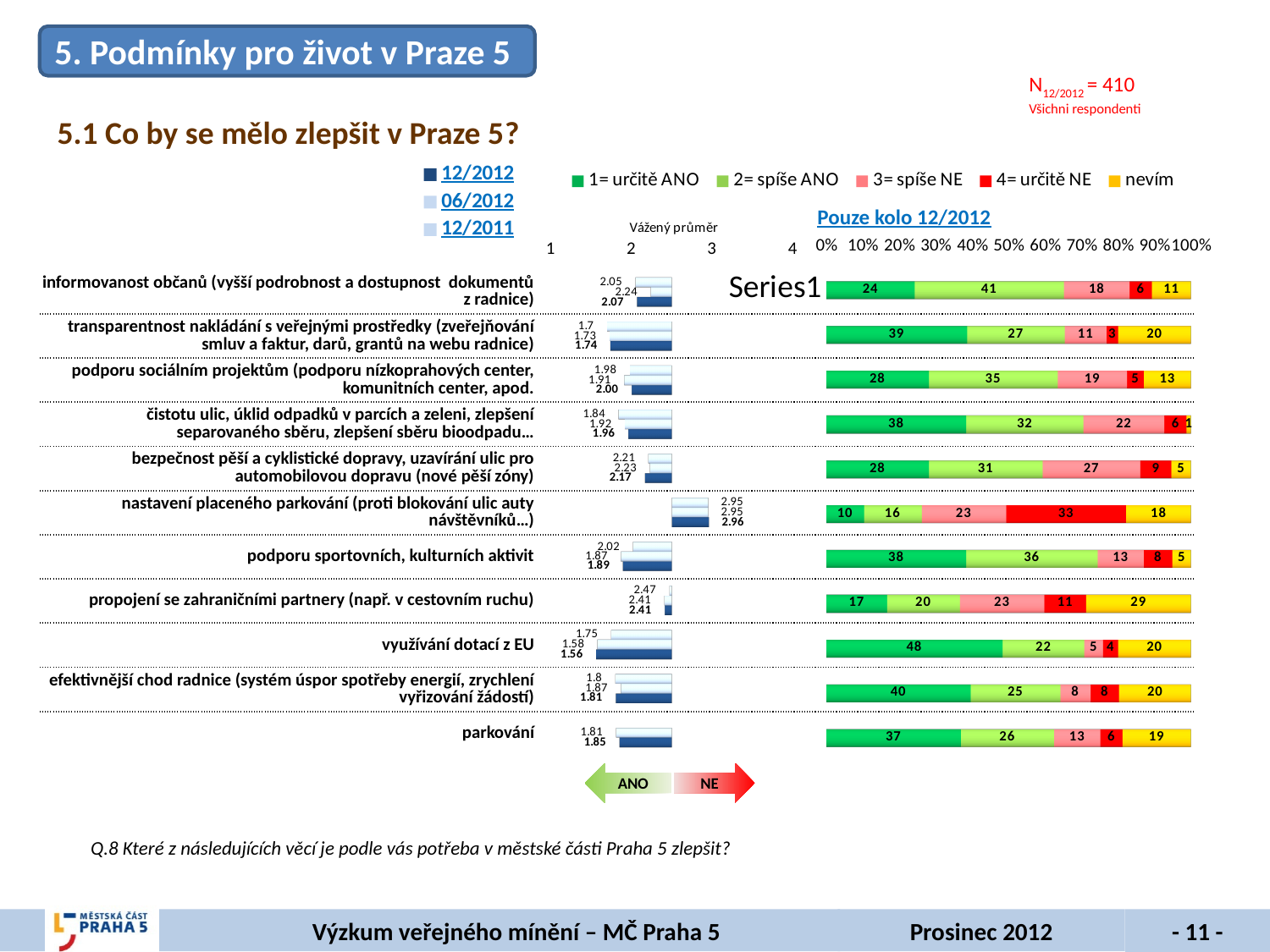
In the stacked bar chart (Pouze kolo 12/2012), which category has the highest value for '1= určitě ANO'? využívání dotací z EU In the stacked bar chart (Pouze kolo 12/2012), which has the larger 'nevím' value: 'transparentnost nakládání s veřejnými prostředky' or 'bezpečnost pěší a cyklistické dopravy'? transparentnost nakládání s veřejnými prostředky In the stacked bar chart (Pouze kolo 12/2012), what is the value of '1= určitě ANO' for 'využívání dotací z EU'? 48 How many categories are shown in the stacked bar chart (Pouze kolo 12/2012)? 11 In the stacked bar chart (Pouze kolo 12/2012), which category has the lowest value for '1= určitě ANO'? nastavení placeného parkování (proti blokování ulic auty návštěvníků...) In the stacked bar chart (Pouze kolo 12/2012), what is the value of '4= určitě NE' for 'nastavení placeného parkování (proti blokování ulic auty návštěvníků...)'? 33 How many series does the legend of the stacked bar chart (Pouze kolo 12/2012) list? 5 In the stacked bar chart (Pouze kolo 12/2012), what is the difference between the '2= spíše ANO' value for 'informovanost občanů' and for 'parkování'? 15 What kind of chart is the 'Pouze kolo 12/2012' chart? stacked bar chart In the stacked bar chart (Pouze kolo 12/2012), what is the value of 'nevím' for 'propojení se zahraničními partnery (např. v cestovním ruchu)'? 29 In the weighted average chart (Vážený průměr), what is the 12/2012 value for 'nastavení placeného parkování'? 2.96 How many series does the legend of the weighted average chart (Vážený průměr) list? 3